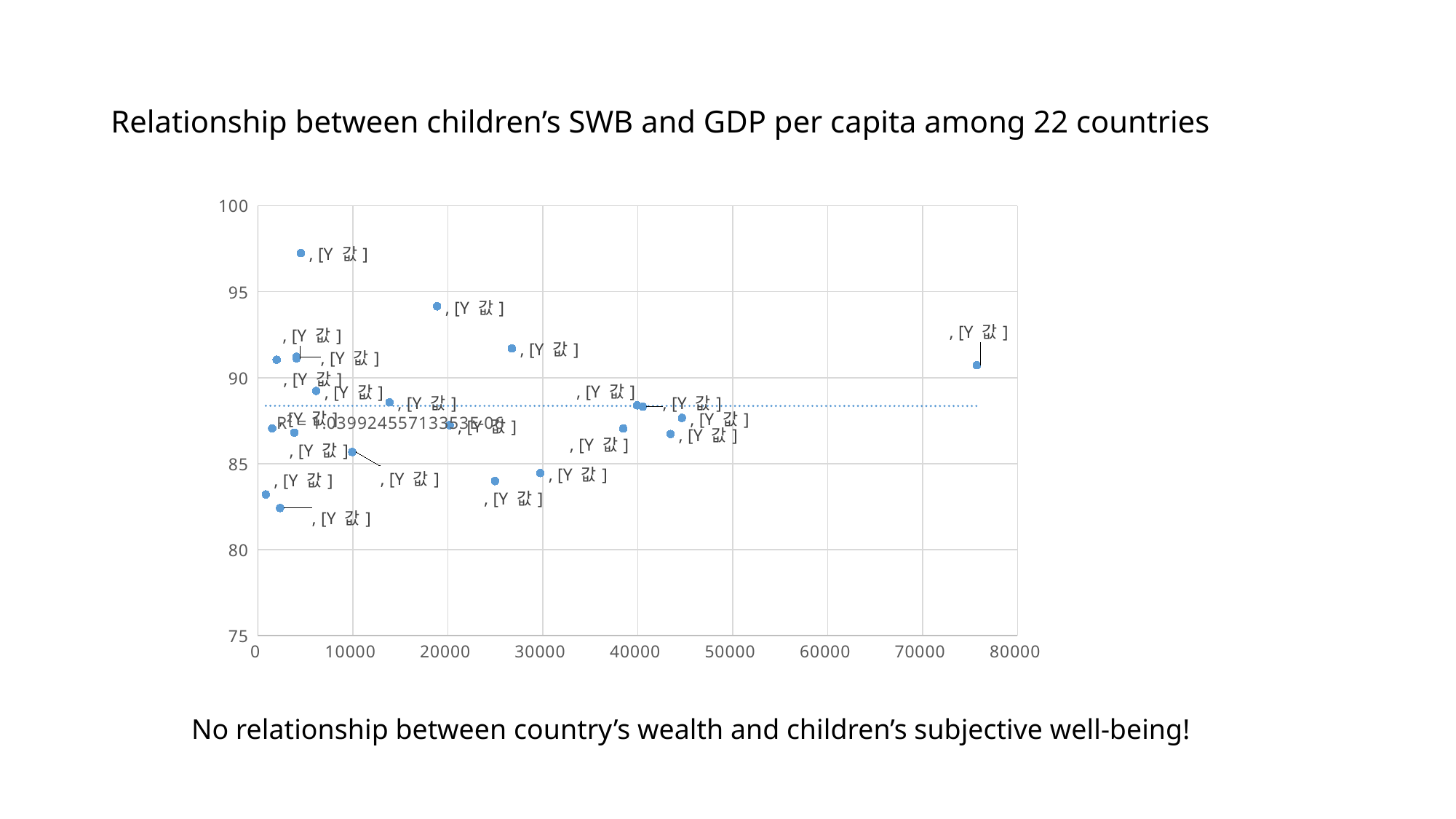
Do the plotted values rise, fall, or stay roughly flat as GDP per capita increases along the x axis? roughly flat Which has the higher value: the point plotted near 19000 on the x axis or the point plotted near 76000 on the x axis? the point near 19000 What is the title of the chart? Relationship between children's SWB and GDP per capita among 22 countries How many points are plotted above 95 on the y axis? 1 Is the value of the point plotted near 25000 on the x axis greater or less than 85? less Is the value of the lowest point on the chart greater or less than 85? less What kind of chart is shown on the slide? scatter chart Is the value of the point plotted near 19000 on the x axis greater or less than 95? less Does the point with the highest value lie to the left or to the right of 10000 on the x axis? left How many points are plotted to the right of 50000 on the x axis? 1